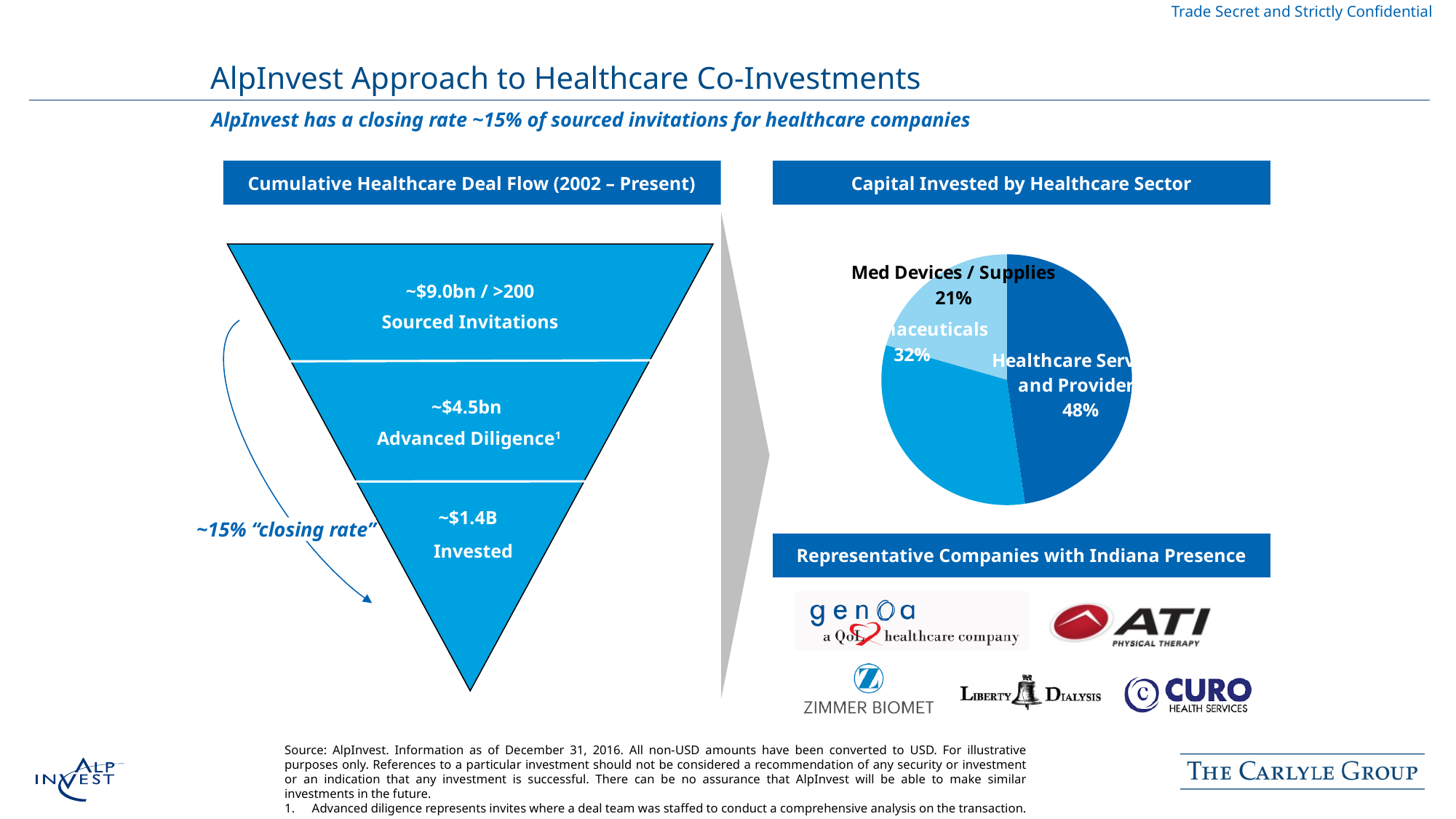
In the "Capital Invested by Healthcare Sector" pie chart, what share is Healthcare Services and Providers? 48% What type of chart is shown under "Capital Invested by Healthcare Sector"? Pie chart How many slices does the "Capital Invested by Healthcare Sector" pie chart have? 3 In the "Cumulative Healthcare Deal Flow (2002 – Present)" funnel, what value is shown for Invested? ~$1.4B In the "Cumulative Healthcare Deal Flow (2002 – Present)" funnel, what value is shown for Advanced Diligence? ~$4.5bn In the "Capital Invested by Healthcare Sector" pie chart, what share is Pharmaceuticals? 32% In the "Capital Invested by Healthcare Sector" pie chart, what share is Med Devices / Supplies? 21% In the "Capital Invested by Healthcare Sector" pie chart, which sector has the largest share? Healthcare Services and Providers In the "Capital Invested by Healthcare Sector" pie chart, which sector has the smallest share? Med Devices / Supplies In the "Capital Invested by Healthcare Sector" pie chart, how many percentage points larger is Healthcare Services and Providers than Pharmaceuticals? 16 percentage points In the "Capital Invested by Healthcare Sector" pie chart, how many percentage points larger is Healthcare Services and Providers than Med Devices / Supplies? 27 percentage points In the "Capital Invested by Healthcare Sector" pie chart, which is larger: Med Devices / Supplies or Pharmaceuticals? Pharmaceuticals